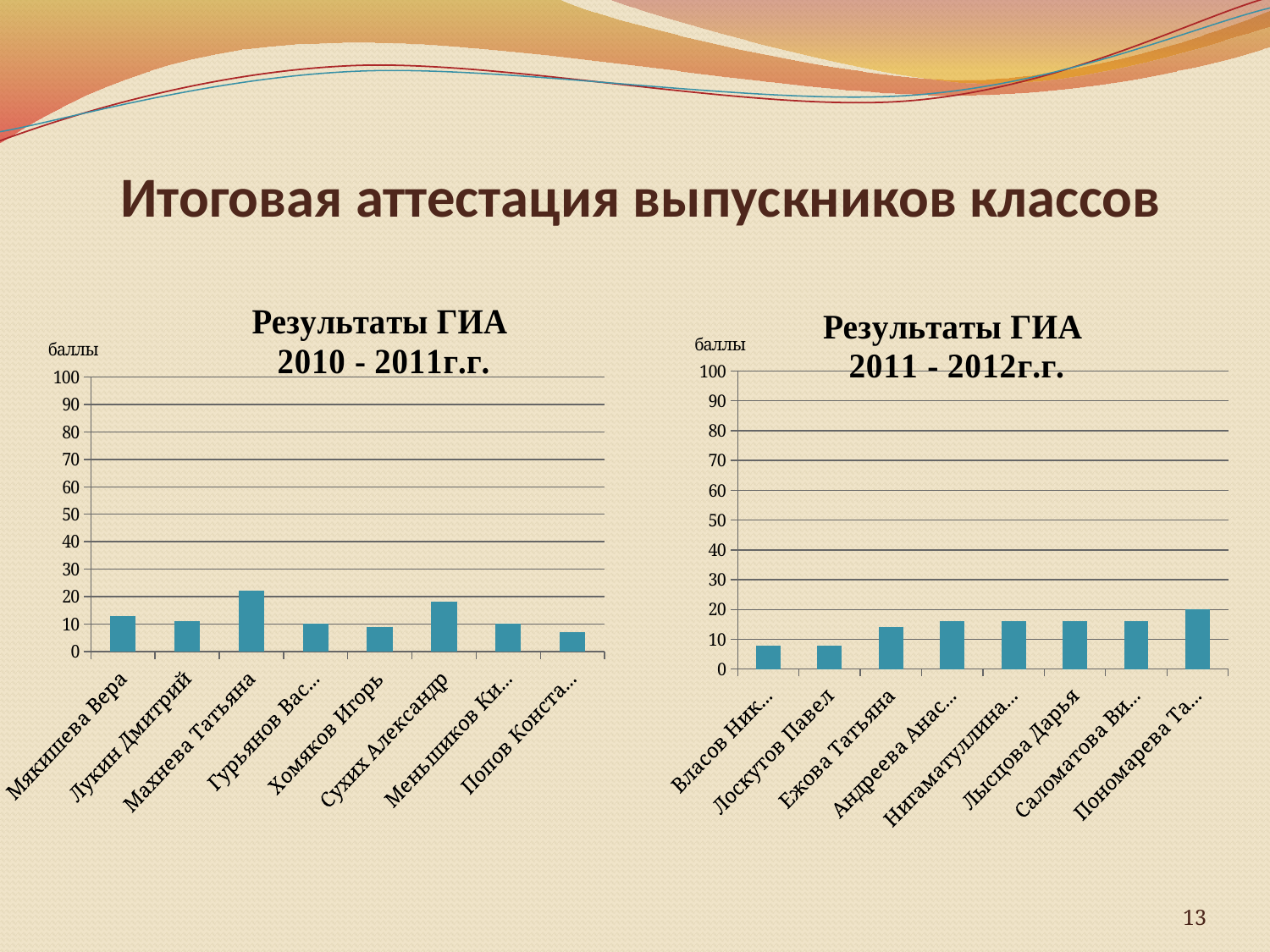
How many students are shown in the left chart (Результаты ГИА 2010 - 2011г.г.)? 8 In the left chart (Результаты ГИА 2010 - 2011г.г.), is the value for Махнева Татьяна greater or less than 10? greater In the left chart (Результаты ГИА 2010 - 2011г.г.), which student has the highest score? Махнева Татьяна What kind of chart is the left chart titled "Результаты ГИА 2010 - 2011г.г."? bar chart How many students are shown in the right chart (Результаты ГИА 2011 - 2012г.г.)? 8 In the left chart (Результаты ГИА 2010 - 2011г.г.), who scored higher, Махнева Татьяна or Сухих Александр? Махнева Татьяна In the left chart (Результаты ГИА 2010 - 2011г.г.), which student has the lowest score? Попов Конста... In the right chart (Результаты ГИА 2011 - 2012г.г.), which student has the highest score? Пономарева Та... What is the label on the vertical axis of the right chart (Результаты ГИА 2011 - 2012г.г.)? баллы In the left chart (Результаты ГИА 2010 - 2011г.г.), is the value for Сухих Александр greater or less than 20? less In the right chart (Результаты ГИА 2011 - 2012г.г.), is the value for Ежова Татьяна greater or less than 20? less In the right chart (Результаты ГИА 2011 - 2012г.г.), who scored higher, Пономарева Та... or Ежова Татьяна? Пономарева Та...